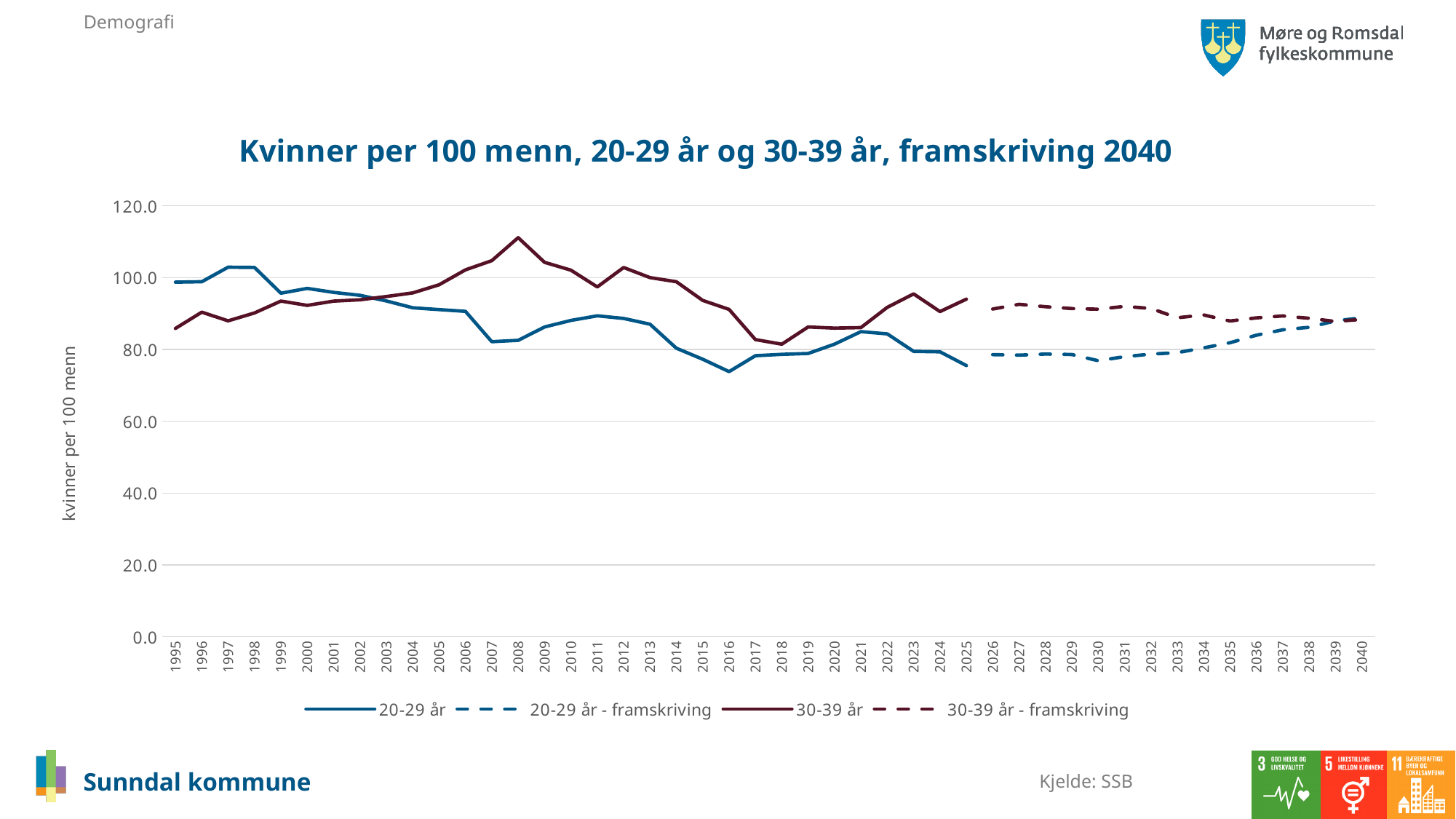
In which year does the 20-29 år series reach its lowest value? 2016 Is the value for 30-39 år in 2017 greater or less than 100? less Is the value for 20-29 år in 2016 greater or less than 80? less What is the label of the vertical axis? kvinner per 100 menn In which year does the 30-39 år series reach its highest value? 2008 How many years are shown on the x axis? 46 In 1997, which series has the larger value, 20-29 år or 30-39 år? 20-29 år Does the 20-29 år - framskriving series rise or fall from 2030 to 2040? rise What is the title of the chart? Kvinner per 100 menn, 20-29 år og 30-39 år, framskriving 2040 How many series does the legend list? 4 Is the value for 30-39 år in 2008 greater or less than 100? greater What kind of chart is shown on the slide? line chart